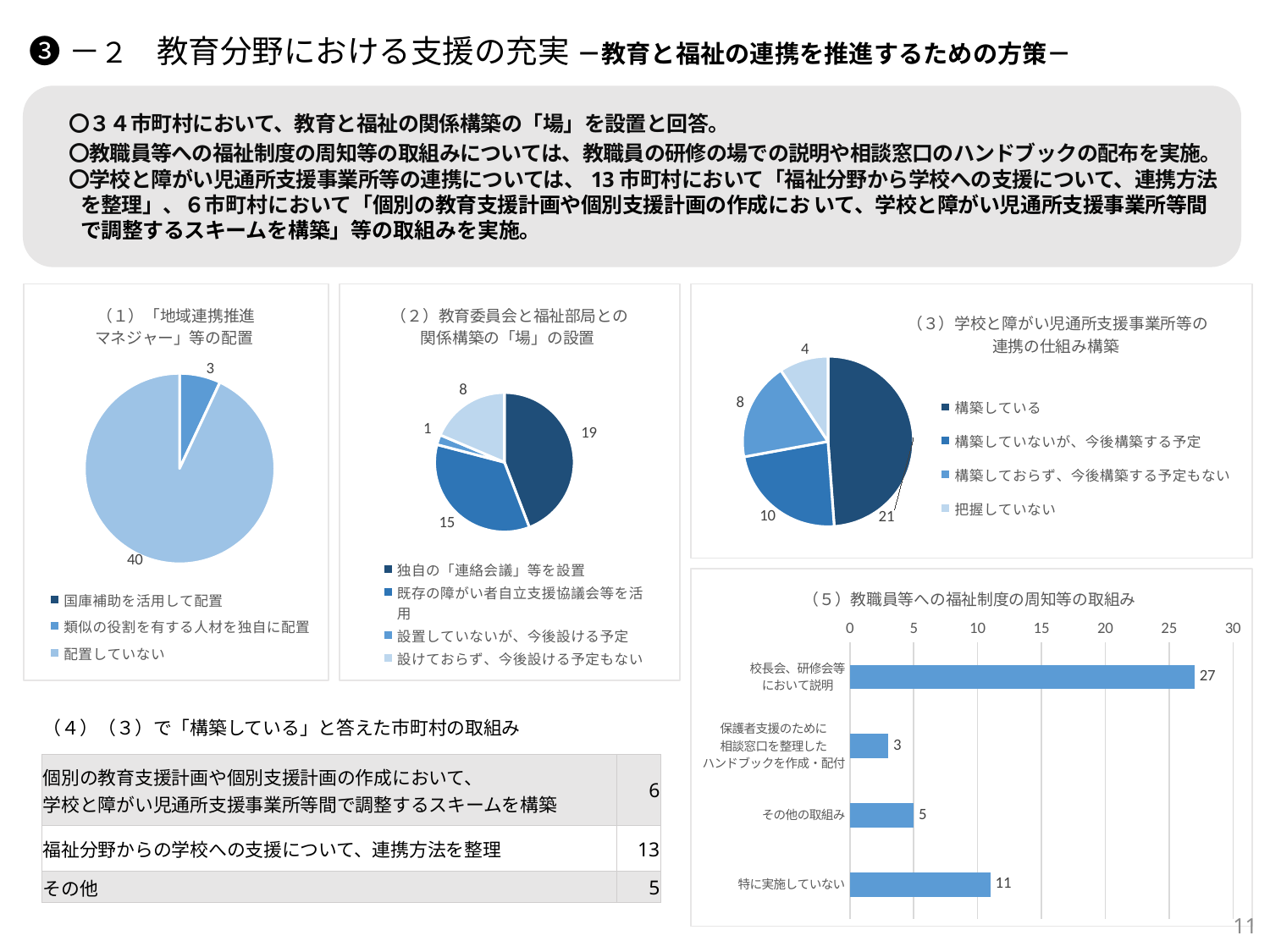
In the chart titled （5）教職員等への福祉制度の周知等の取組み, what is the difference between the values for 校長会、研修会等において説明 and その他の取組み? 22 In the pie chart titled （2）教育委員会と福祉部局との関係構築の「場」の設置, what is the value for 独自の「連絡会議」等を設置? 19 In the chart titled （5）教職員等への福祉制度の周知等の取組み, what is the value for 特に実施していない? 11 In the chart titled （5）教職員等への福祉制度の周知等の取組み, what is the value for 校長会、研修会等において説明? 27 What kind of chart is the chart titled （5）教職員等への福祉制度の周知等の取組み? bar chart In the chart titled （5）教職員等への福祉制度の周知等の取組み, how many categories are shown? 4 In the pie chart titled （3）学校と障がい児通所支援事業所等の連携の仕組み構築, what is the value for 構築している? 21 In the pie chart titled （2）教育委員会と福祉部局との関係構築の「場」の設置, which is larger: 既存の障がい者自立支援協議会等を活用 or 設けておらず、今後設ける予定もない? 既存の障がい者自立支援協議会等を活用 In the chart titled （5）教職員等への福祉制度の周知等の取組み, which category has the lowest value? 保護者支援のために相談窓口を整理したハンドブックを作成・配付 In the pie chart titled （1）「地域連携推進マネジャー」等の配置, what is the value for 配置していない? 40 In the pie chart titled （3）学校と障がい児通所支援事業所等の連携の仕組み構築, which category has the smallest value? 把握していない In the pie chart titled （3）学校と障がい児通所支援事業所等の連携の仕組み構築, how many categories does the legend list? 4